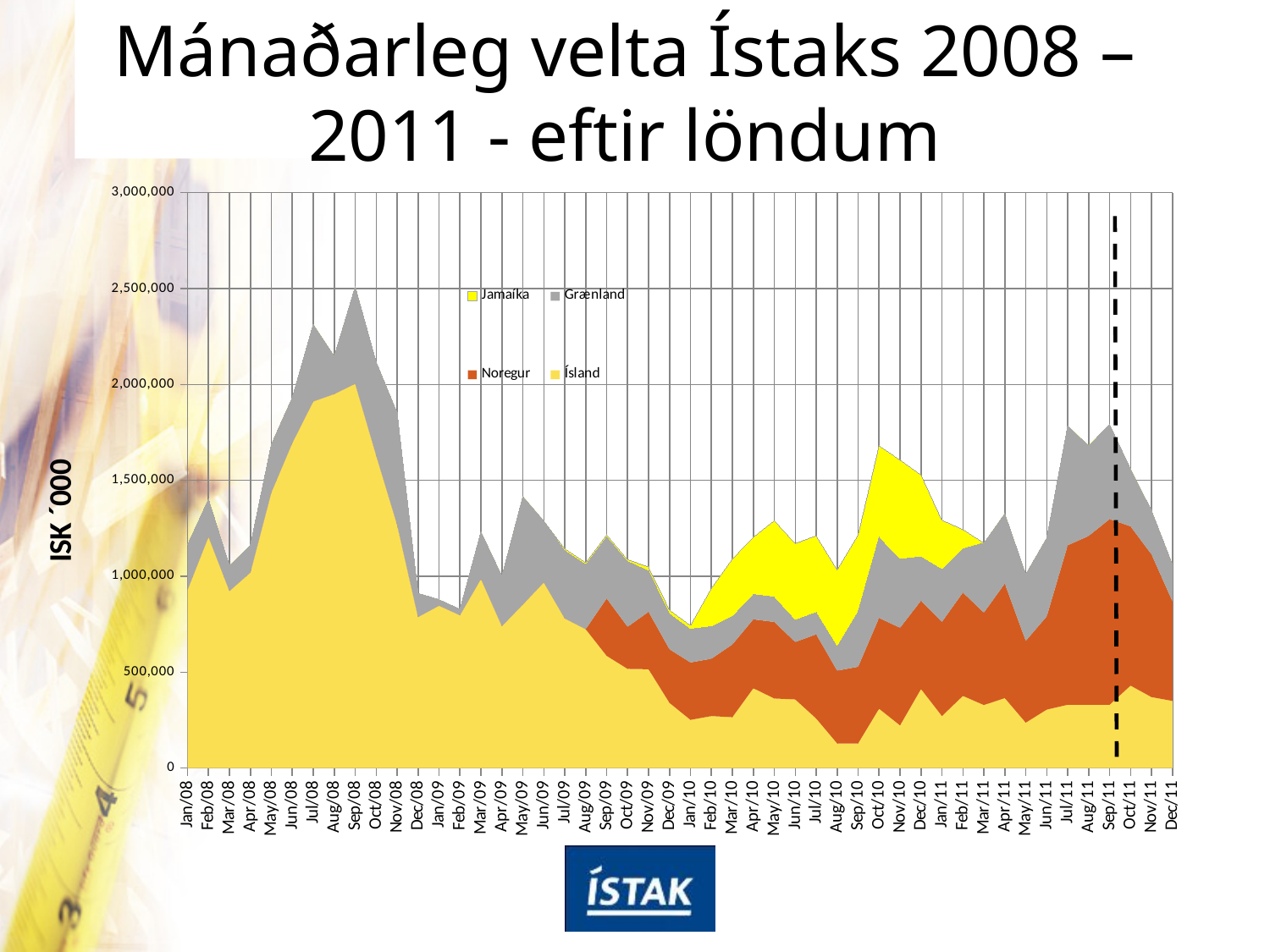
What label is shown on the vertical axis? ISK ´000 What is the title of the slide's chart? Mánaðarleg velta Ístaks 2008 – 2011 - eftir löndum How many monthly data points are plotted along the x axis? 48 Is the total stacked value for Oct/10 greater or less than 1,500,000? greater Is the total stacked value for Sep/08 greater or less than 2,000,000? greater Do the total values rise or fall from Jan/08 to Sep/08? rise In which month is the total stacked value highest? Sep/08 Which is larger, the Ísland value in Jan/08 or the Ísland value in Dec/11? Jan/08 What kind of chart is shown on the slide? Stacked area chart Is the total stacked value for Jan/10 greater or less than 1,000,000? less How many series does the legend list? 4